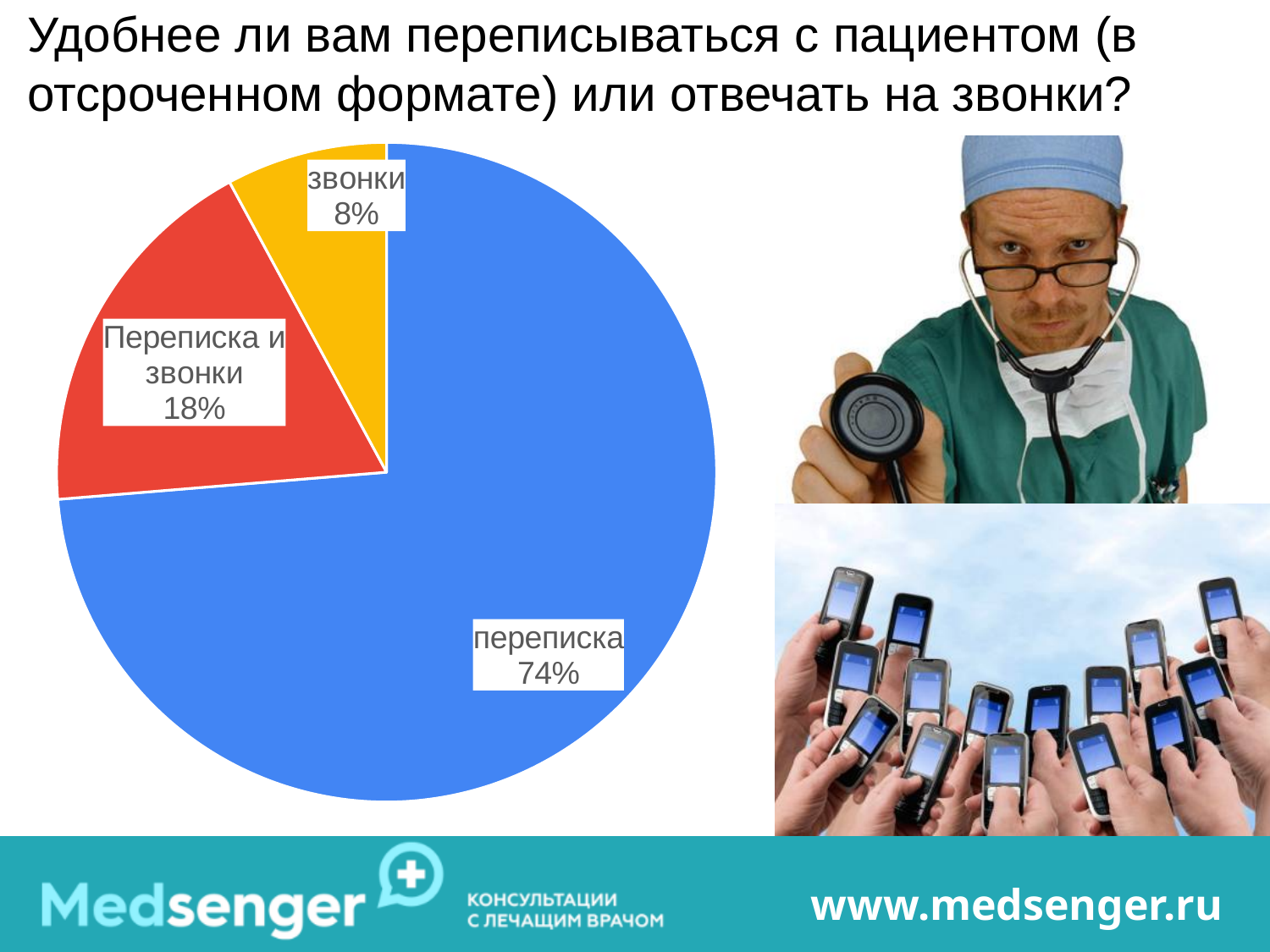
Which slice of the pie is the smallest? звонки What share of the pie does "звонки" have? 8% What share of the pie does "переписка" have? 74% Which slice of the pie is the largest? переписка What colour is the "звонки" slice? yellow What is the difference in percentage points between "Переписка и звонки" and "звонки"? 10 Which is larger, the share for "Переписка и звонки" or the share for "звонки"? Переписка и звонки What is the difference in percentage points between "переписка" and "Переписка и звонки"? 56 What colour is the "переписка" slice? blue What kind of chart is shown on the slide? pie chart What share of the pie does "Переписка и звонки" have? 18% How many slices does the pie chart have? 3